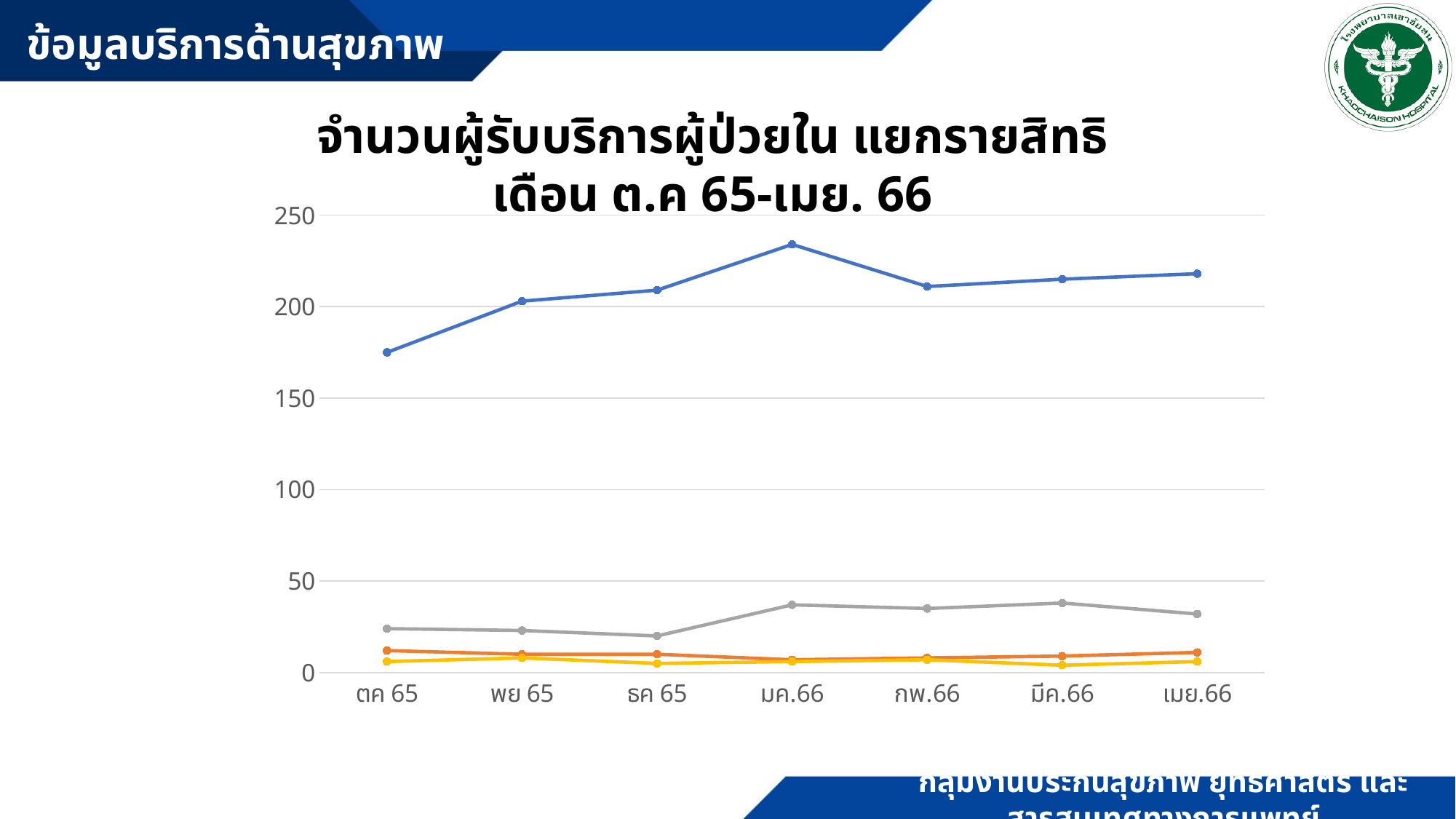
In which month does the blue line reach its highest value? มค.66 Does the blue line rise or fall from ตค 65 to มค.66? rise In which month does the gray line have its lowest value? ธค 65 What period does the chart title say the data covers? ต.ค 65-เมย. 66 What kind of chart is shown on the slide? line chart How many months are plotted along the x axis? 7 Is the value of the blue line for เมย.66 greater or less than 200? greater Is the value of the blue line for ตค 65 greater or less than 200? less In which month does the blue line have its lowest value? ตค 65 Which line is higher at กพ.66, the blue line or the gray line? the blue line Is the value of the gray line for มค.66 greater or less than 50? less